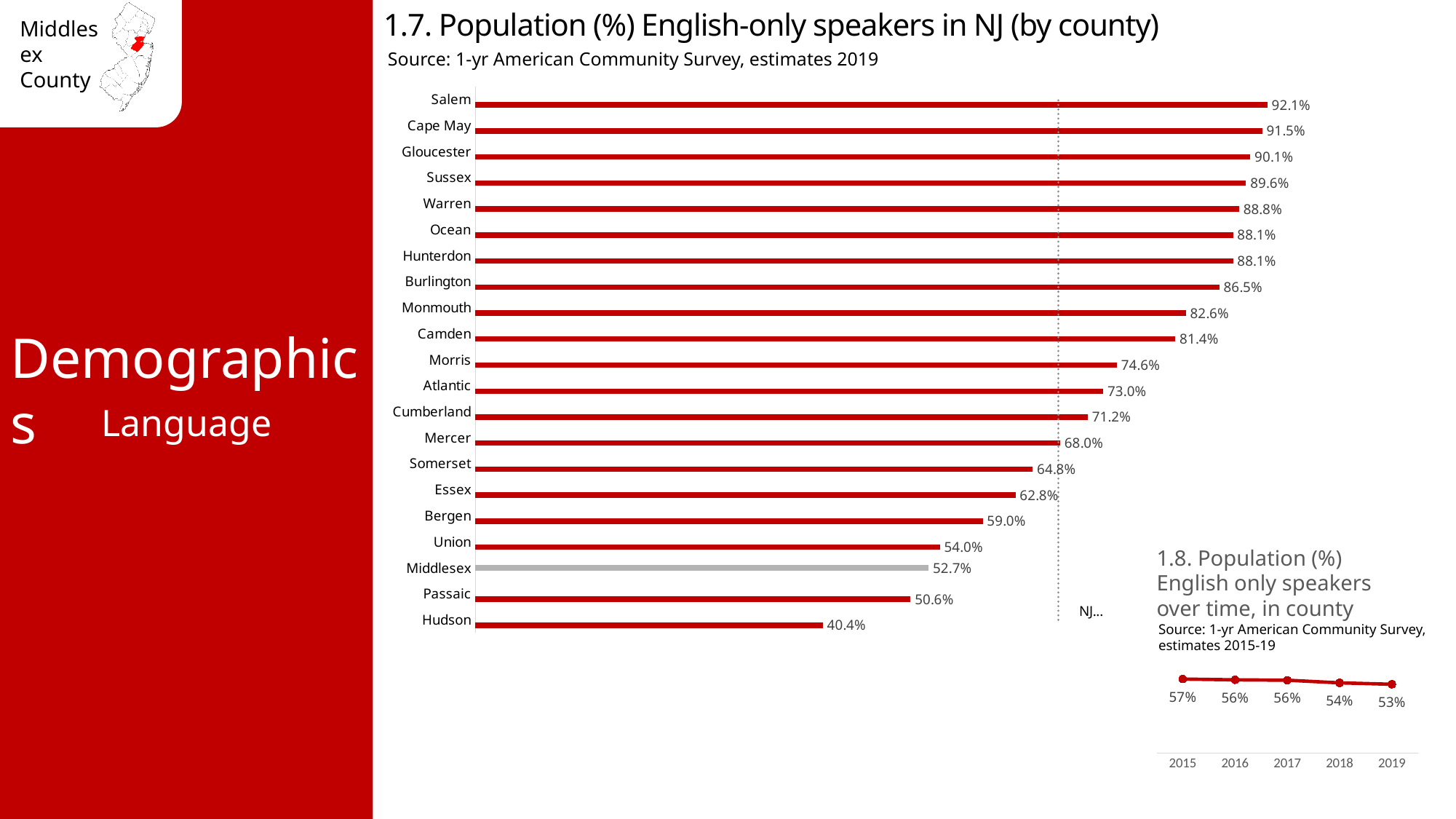
In the chart '1.8. Population (%) English only speakers over time, in county', do the values rise or fall from 2015 to 2019? Fall In the chart '1.7. Population (%) English-only speakers in NJ (by county)', which county has the lowest value? Hudson In the chart '1.7. Population (%) English-only speakers in NJ (by county)', which is larger, Bergen or Union? Bergen In the chart '1.7. Population (%) English-only speakers in NJ (by county)', which county's bar is coloured grey instead of red? Middlesex What kind of chart is '1.7. Population (%) English-only speakers in NJ (by county)'? Bar chart In the chart '1.7. Population (%) English-only speakers in NJ (by county)', what is the value for Middlesex? 52.7% In the chart '1.8. Population (%) English only speakers over time, in county', what is the value for 2019? 53% In the chart '1.7. Population (%) English-only speakers in NJ (by county)', what is the value for Gloucester? 90.1% In the chart '1.7. Population (%) English-only speakers in NJ (by county)', which county has the highest value? Salem In the chart '1.7. Population (%) English-only speakers in NJ (by county)', what is the difference between Salem and Hudson? 51.7% In the chart '1.8. Population (%) English only speakers over time, in county', what is the difference between 2015 and 2019? 4% In the chart '1.7. Population (%) English-only speakers in NJ (by county)', how many counties are shown? 21